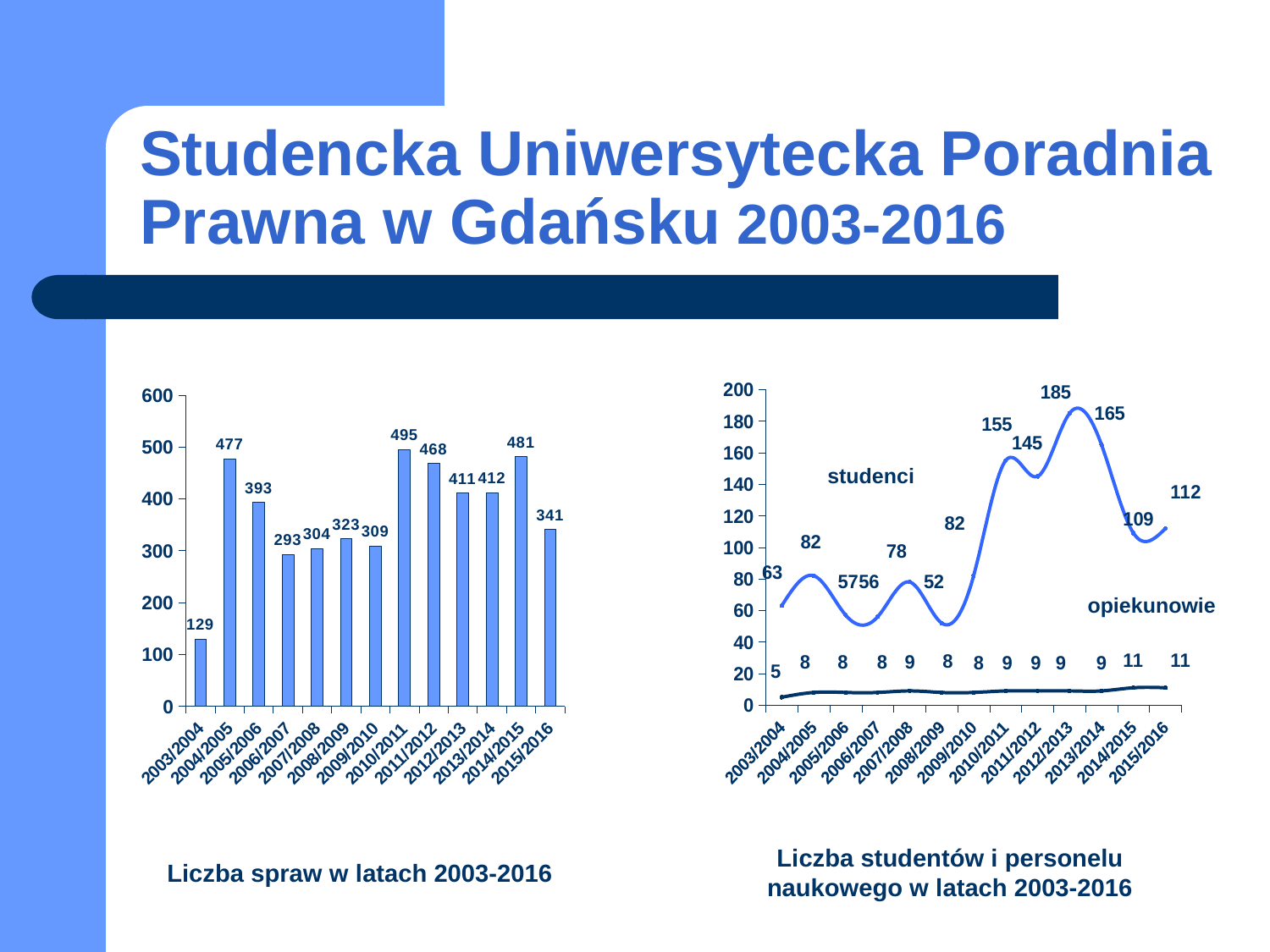
In the chart 'Liczba spraw w latach 2003-2016', which year has the lowest value? 2003/2004 In the chart 'Liczba studentów i personelu naukowego w latach 2003-2016', in which year is the studenci value highest? 2012/2013 In the chart 'Liczba spraw w latach 2003-2016', what is the value for 2010/2011? 495 In the chart 'Liczba studentów i personelu naukowego w latach 2003-2016', what is the value for opiekunowie in 2003/2004? 5 In the chart 'Liczba studentów i personelu naukowego w latach 2003-2016', what is the value for studenci in 2012/2013? 185 In the chart 'Liczba spraw w latach 2003-2016', which is larger, the value for 2004/2005 or the value for 2011/2012? 2004/2005 What kind of chart is 'Liczba studentów i personelu naukowego w latach 2003-2016'? line chart What kind of chart is 'Liczba spraw w latach 2003-2016'? bar chart In the chart 'Liczba spraw w latach 2003-2016', what is the difference between the values for 2014/2015 and 2015/2016? 140 How many years are shown in the chart 'Liczba spraw w latach 2003-2016'? 13 In the chart 'Liczba spraw w latach 2003-2016', which year has the highest value? 2010/2011 In the chart 'Liczba studentów i personelu naukowego w latach 2003-2016', what is the difference between the studenci values for 2010/2011 and 2011/2012? 10